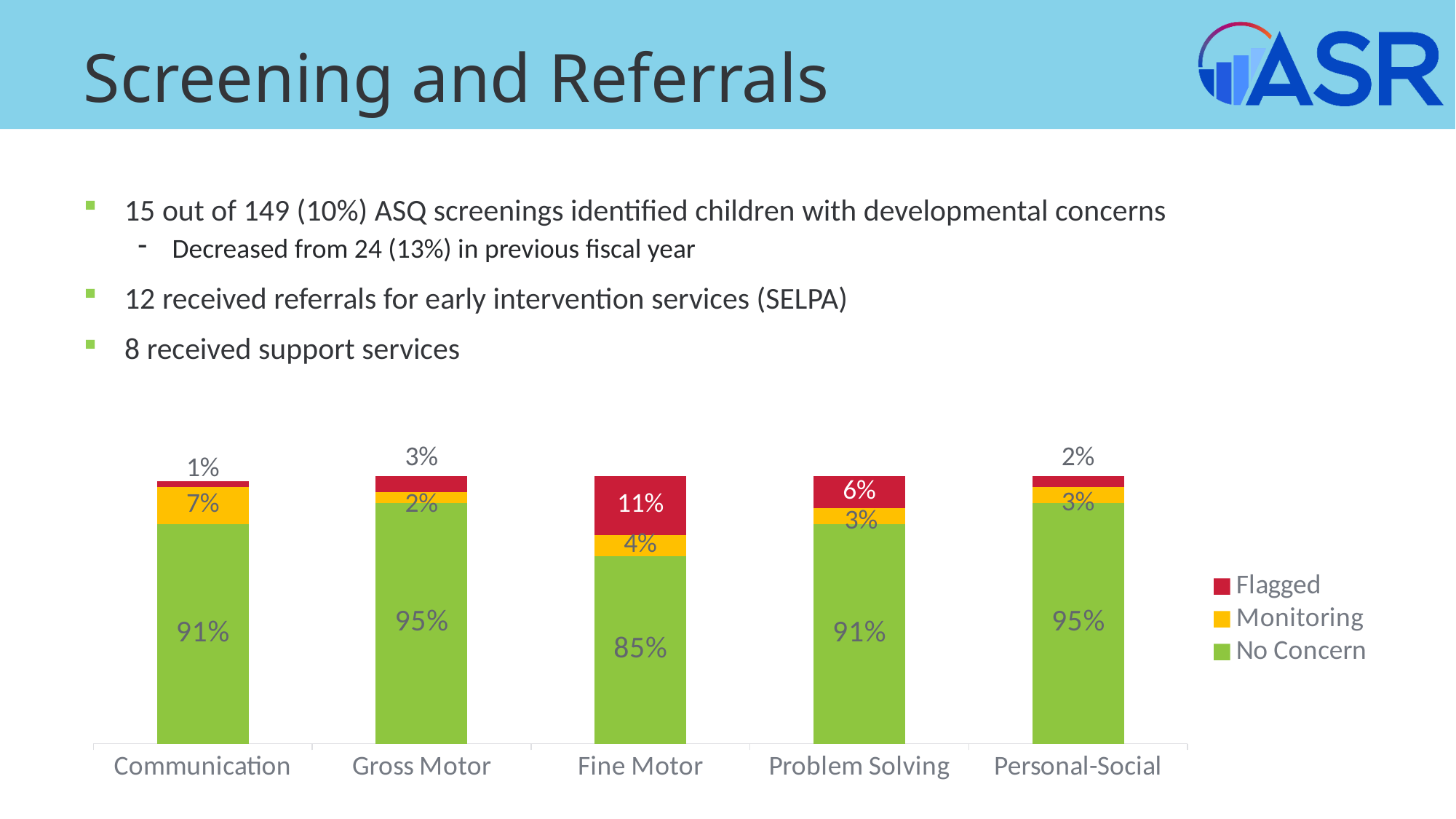
How many categories are shown on the x axis of the chart? 5 What is the No Concern value for Fine Motor? 85% What is the total of the stacked bar for Communication? 99% How many series does the chart legend list? 3 What is the Monitoring value for Communication? 7% Which category has the lowest Flagged value? Communication What is the difference between the Flagged values for Fine Motor and Problem Solving? 5% Which category has the lowest No Concern value? Fine Motor What kind of chart is shown on the slide? Stacked bar chart Which category has the highest Flagged value? Fine Motor Which is larger, the Monitoring value for Communication or the Monitoring value for Fine Motor? Communication What is the Flagged value for Problem Solving? 6%